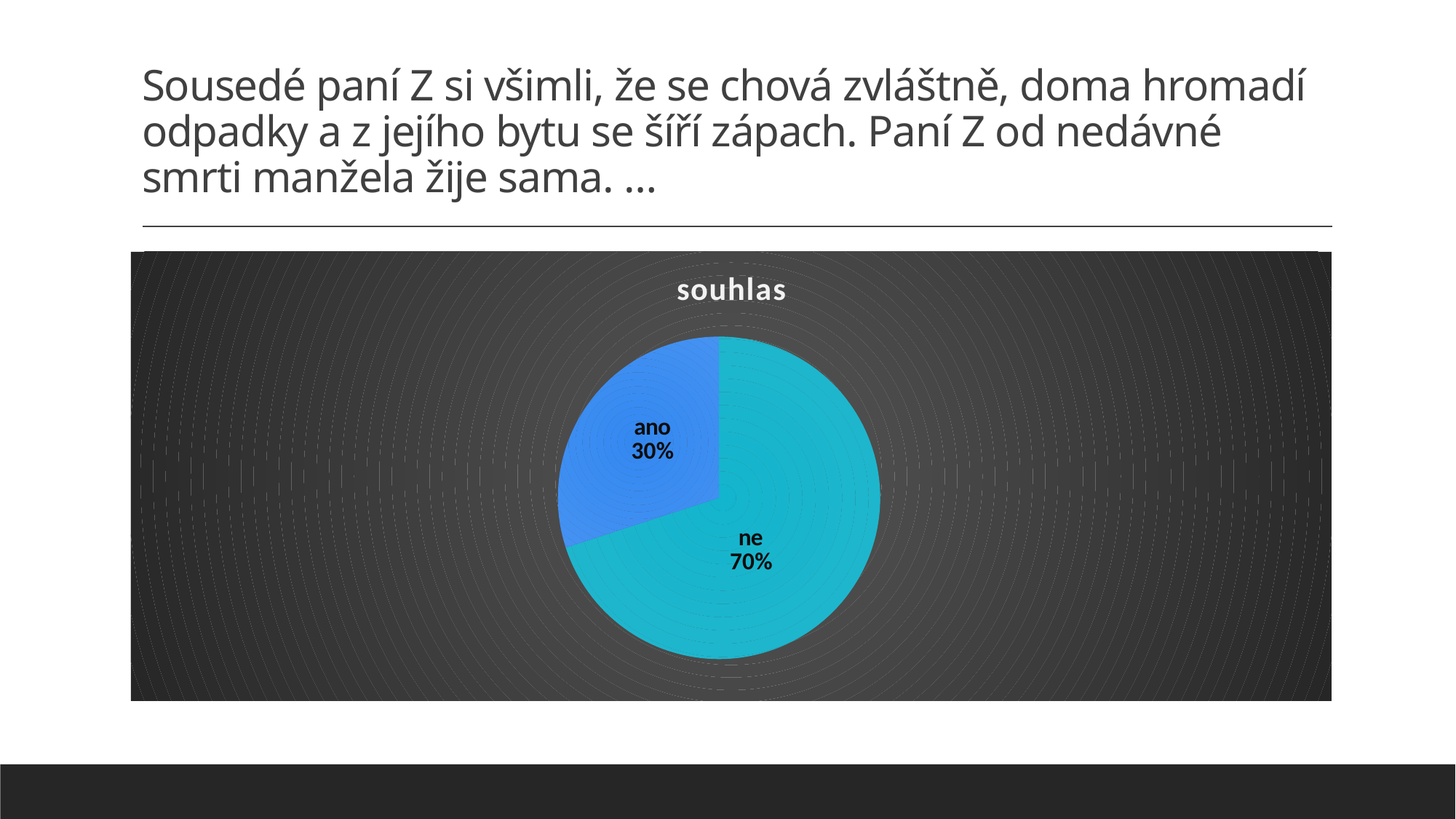
What kind of chart is shown on the slide? pie chart What share of the pie does the "ano" slice represent? 30% How many slices does the pie chart have? 2 What share of the pie does the "ne" slice represent? 70% Which slice is the largest in the pie chart? ne What colour is the "ne" slice of the pie chart? cyan What is the difference in percentage points between the "ne" and "ano" slices? 40 Which slice is the smallest in the pie chart? ano Which is larger, the "ano" slice or the "ne" slice? ne What is the title of the chart? souhlas